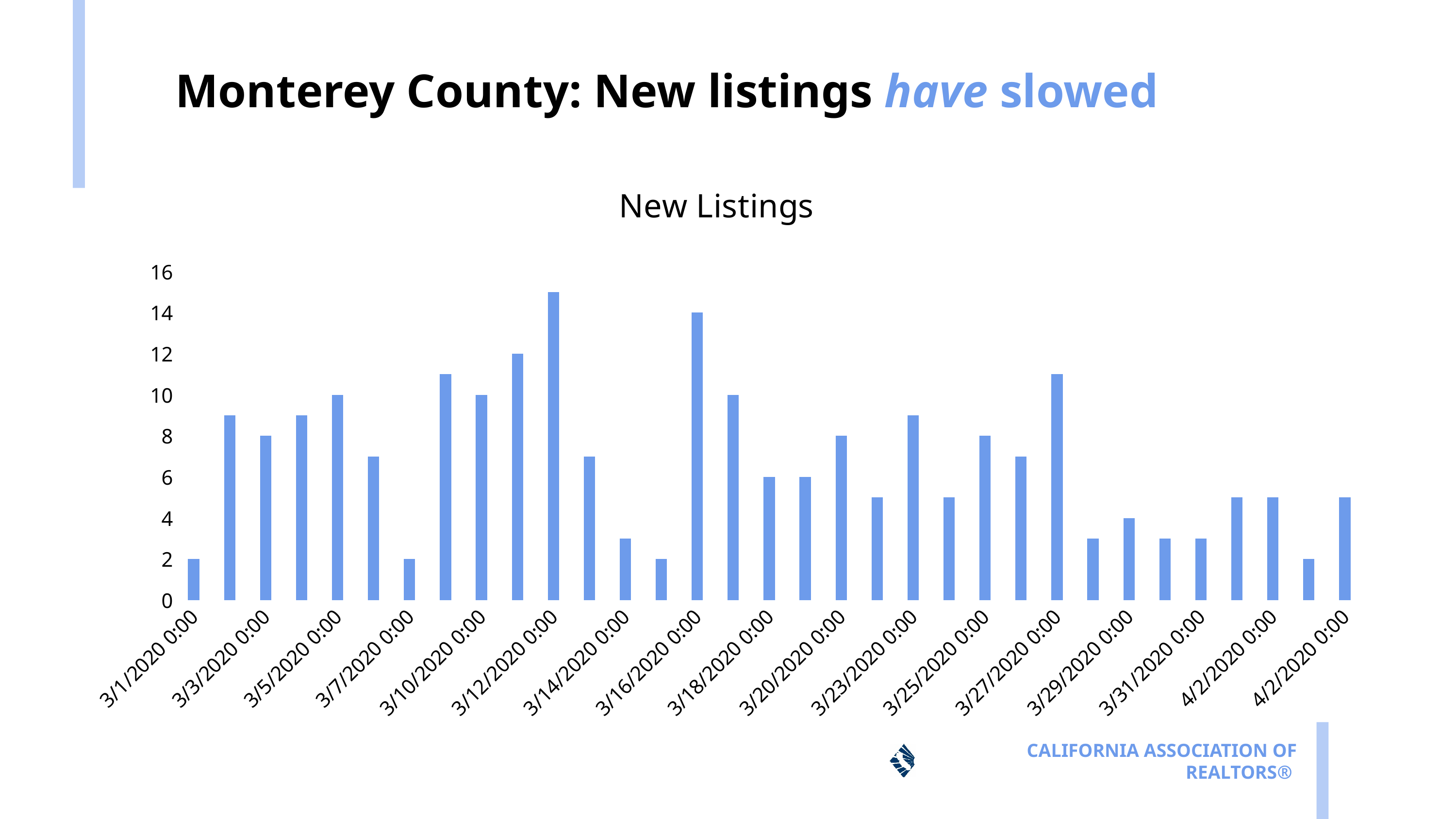
Is the value for 3/27/2020 0:00 greater or less than 10? greater Which labeled date has the highest number of new listings? 3/12/2020 0:00 What is the value for 3/16/2020 0:00? 14 What is the title of the chart? New Listings What is the value for 3/29/2020 0:00? 4 What is the value for 3/1/2020 0:00? 2 Which is larger, the value for 3/16/2020 0:00 or 3/18/2020 0:00? 3/16/2020 0:00 What is the difference between the values for 3/5/2020 0:00 and 3/1/2020 0:00? 8 What type of chart is shown on the slide? bar chart Is the value for 3/12/2020 0:00 greater or less than 14? greater What is the value for 3/5/2020 0:00? 10 How many bars are plotted in the chart? 33